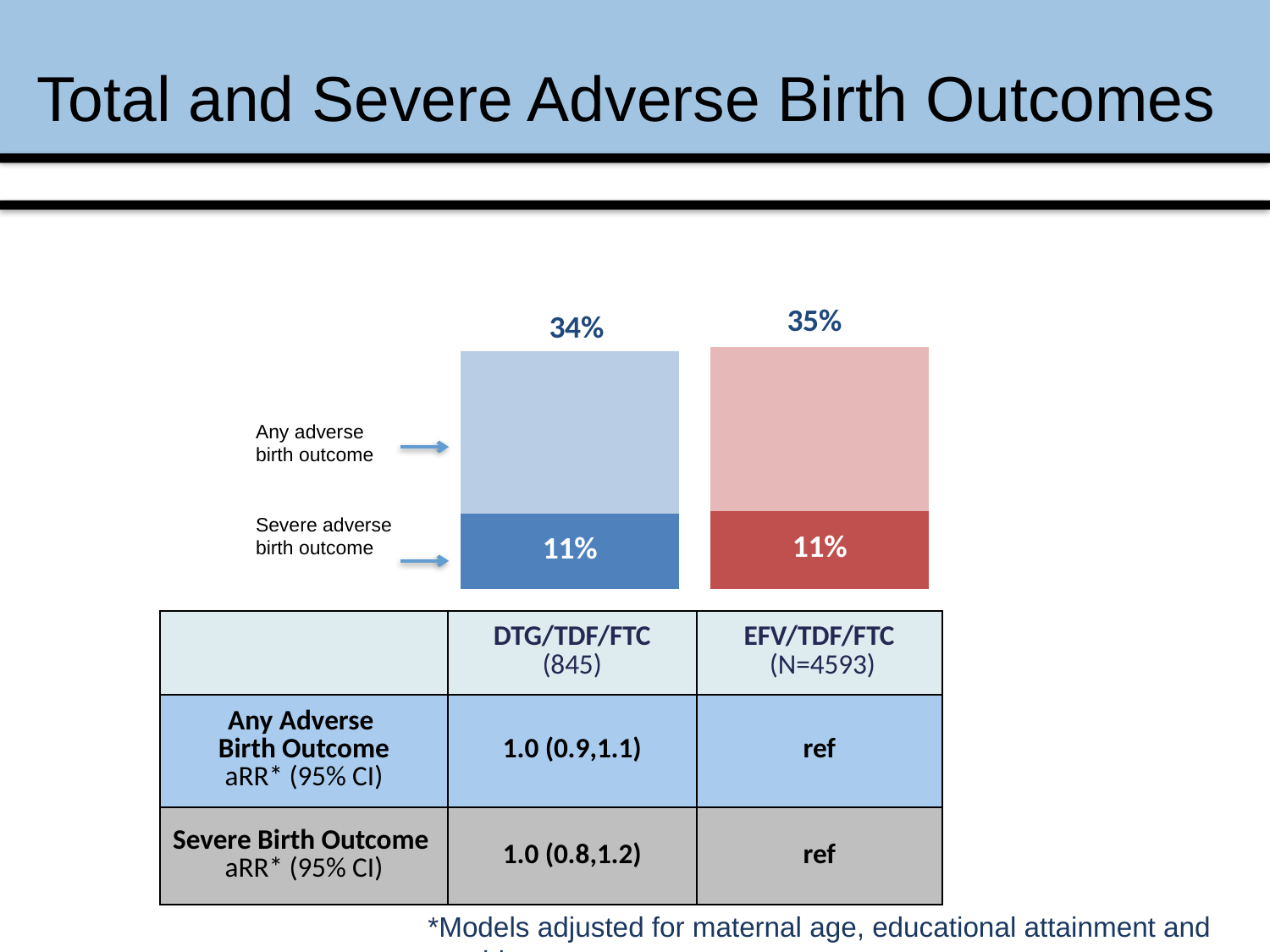
What is the difference in the any adverse birth outcome percentage between the EFV/TDF/FTC bar (35%) and the DTG/TDF/FTC bar (34%)? 1 percentage point Which group has the higher percentage of any adverse birth outcome, DTG/TDF/FTC or EFV/TDF/FTC? EFV/TDF/FTC In the left (DTG/TDF/FTC) bar, what is the difference between the any adverse birth outcome value (34%) and the severe adverse birth outcome value (11%)? 23 percentage points What is the title of the slide containing the chart? Total and Severe Adverse Birth Outcomes What percentage is shown for severe adverse birth outcome in the right (red, EFV/TDF/FTC) bar? 11% Is the severe adverse birth outcome percentage the same for both bars? Yes, 11% for both What percentage is shown for severe adverse birth outcome in the left (blue, DTG/TDF/FTC) bar? 11% What kind of chart is shown on the slide? Bar chart What percentage is shown for any adverse birth outcome in the right (red, EFV/TDF/FTC) bar? 35% How many bars are plotted in the chart? 2 What colour is the bar for the DTG/TDF/FTC group? Blue What percentage is shown for any adverse birth outcome in the left (blue, DTG/TDF/FTC) bar? 34%